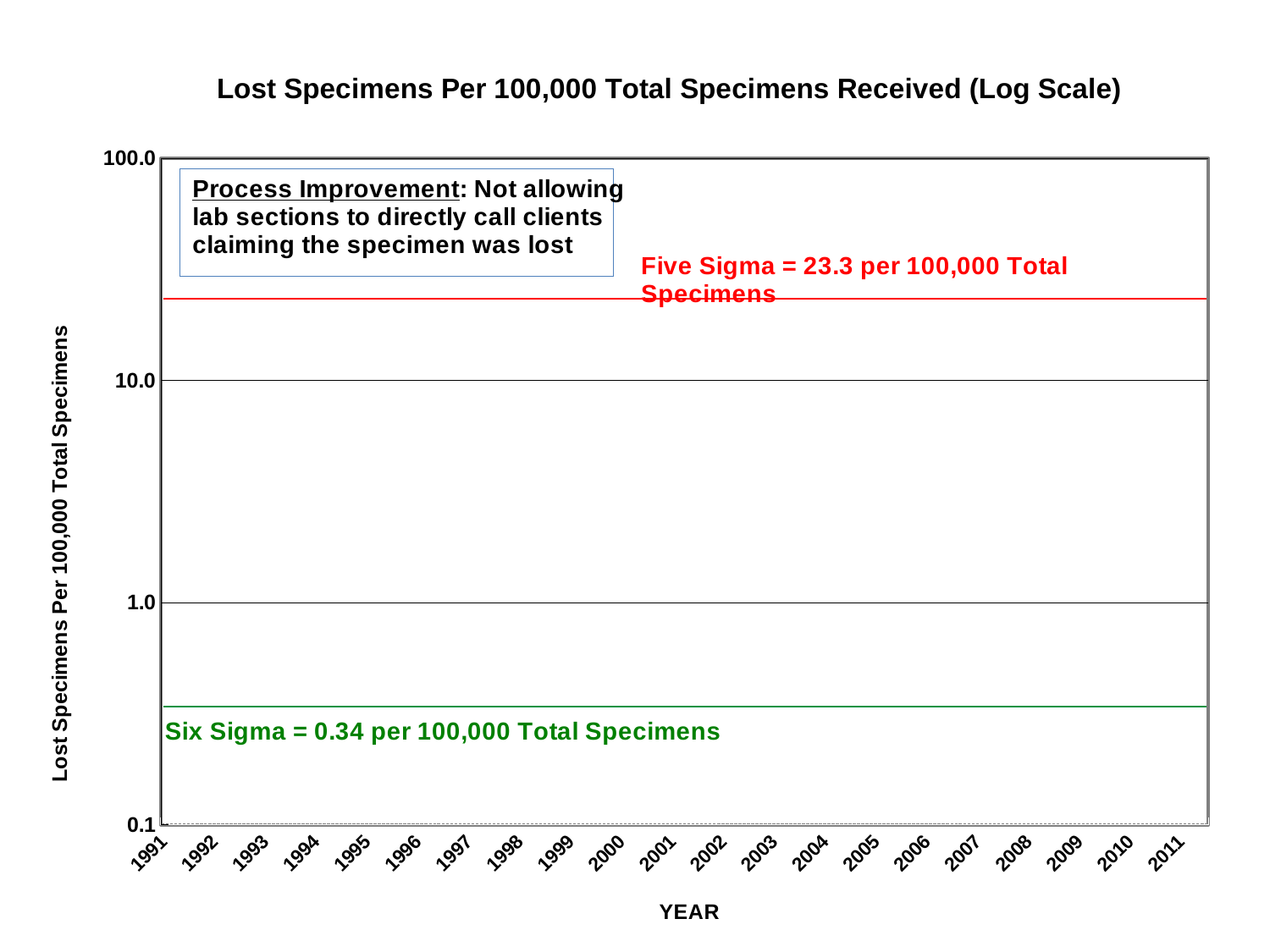
How many years are labelled on the x axis? 21 Is the Five Sigma line greater or less than 10.0 on the y axis? greater What is the highest value shown on the y axis? 100.0 What value does the Six Sigma reference line represent? 0.34 per 100,000 Total Specimens What is the first year shown on the x axis? 1991 What is the label of the x axis? YEAR What is the title of the chart? Lost Specimens Per 100,000 Total Specimens Received (Log Scale) Is the Six Sigma line greater or less than 1.0 on the y axis? less What is the difference between the Five Sigma value and the Six Sigma value? 22.96 What is the last year shown on the x axis? 2011 What value does the Five Sigma reference line represent? 23.3 per 100,000 Total Specimens Which reference line is higher on the chart, Five Sigma or Six Sigma? Five Sigma